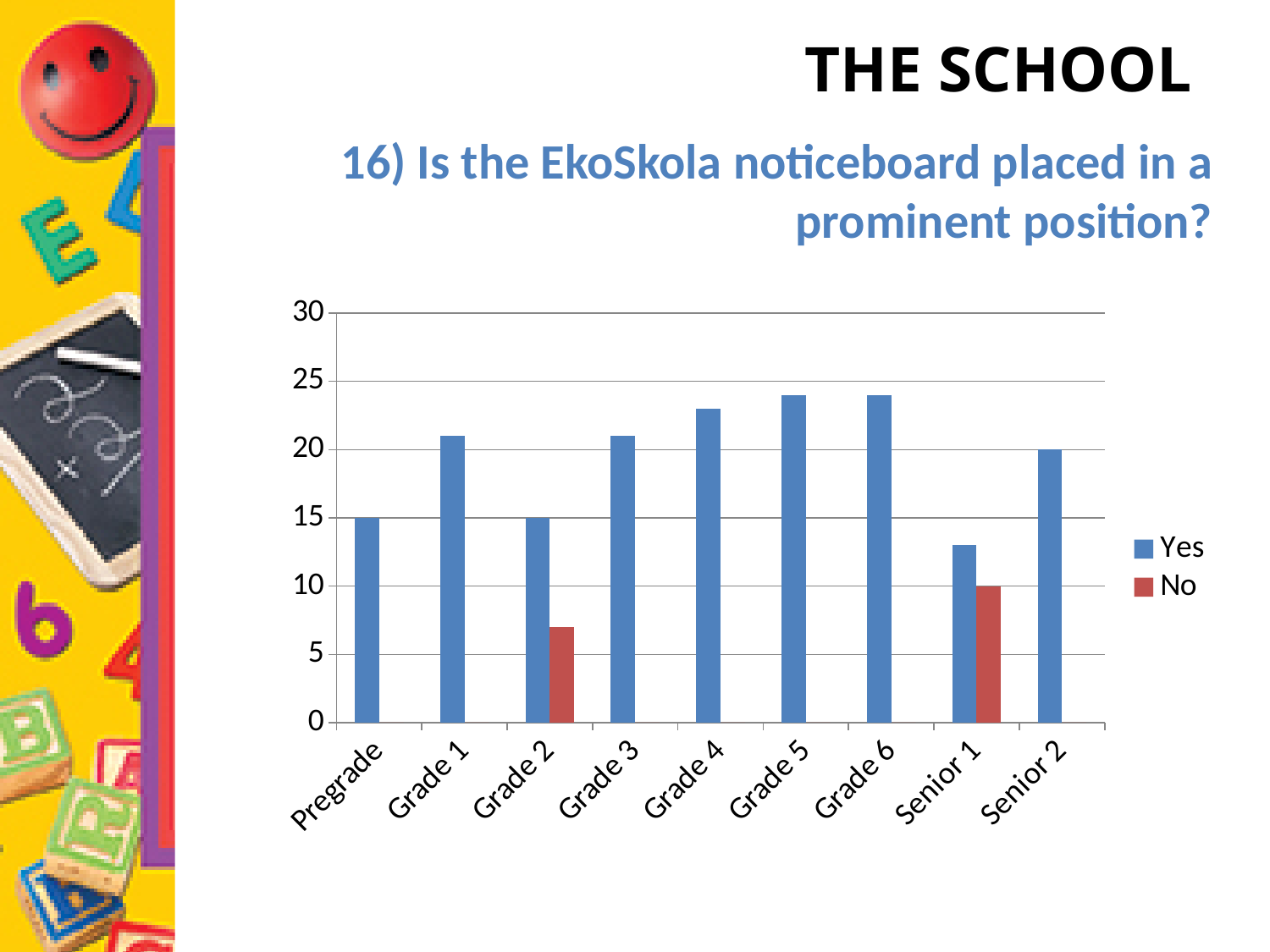
How many grade categories are shown on the x axis? 9 Is the Yes value for Grade 4 greater or less than 20? greater What is the Yes value for Pregrade? 15 What is the Yes value for Senior 2? 20 How many series does the legend list? 2 Is the No value for Grade 2 greater or less than 10? less Which is larger, the Yes value for Grade 1 or the Yes value for Grade 2? Grade 1 What kind of chart is shown on the slide? bar chart What is the No value for Senior 1? 10 Which categories have a No bar? Grade 2 and Senior 1 What colour are the Yes bars? blue Which category has the lowest Yes value? Senior 1